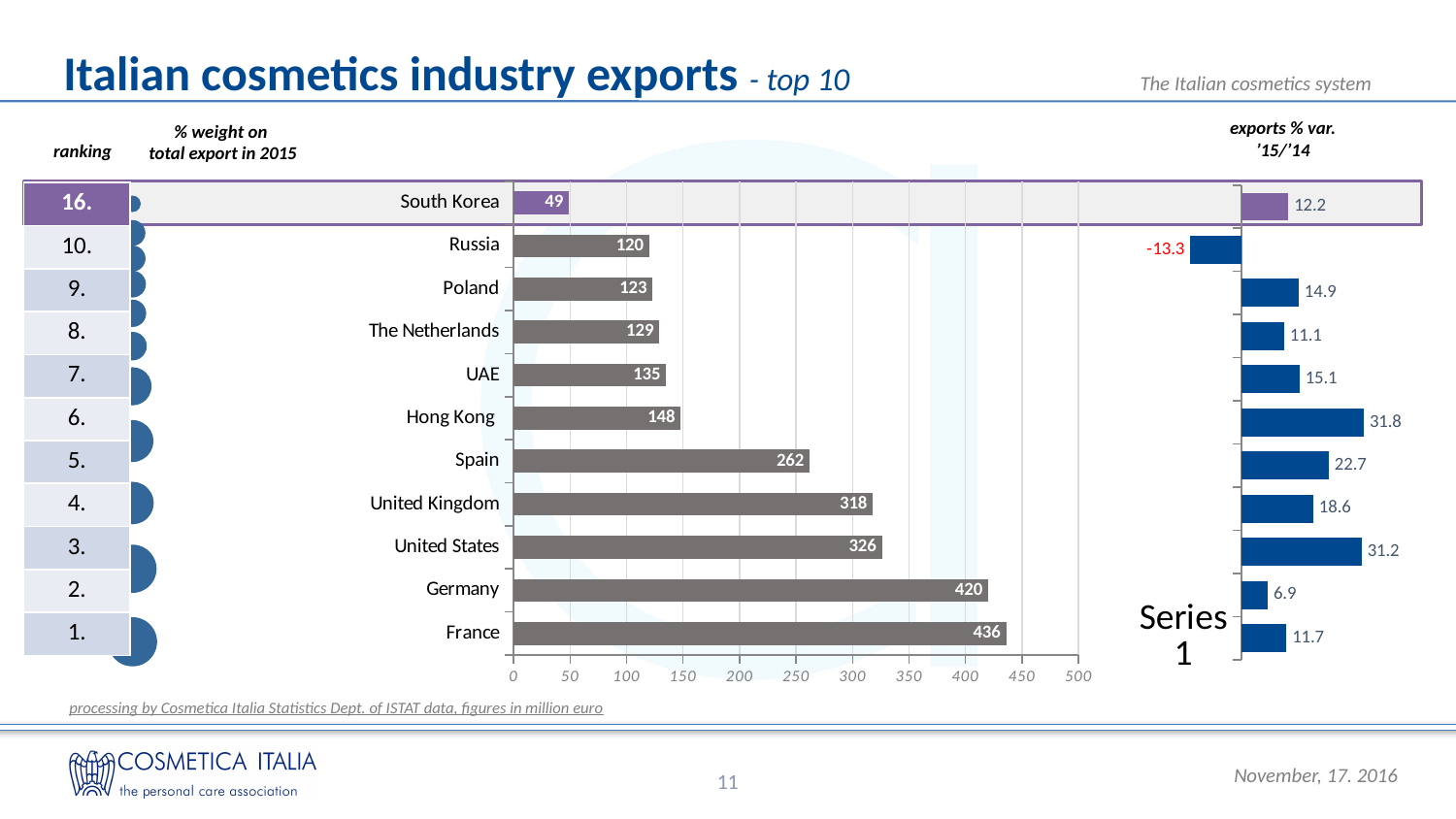
In the left chart of export values, which country has the lowest value? South Korea What kind of chart is the left chart of export values? bar chart How many countries are plotted in the left chart of export values? 11 In the left chart of export values, what is the value for France? 436 In the left chart of export values, what is the difference between France and Germany? 16 In the right chart of exports % var. '15/'14, what is the value for Hong Kong? 31.8 In the left chart of export values, what is the value for Hong Kong? 148 In the right chart of exports % var. '15/'14, which is larger, Spain or Germany? Spain In the right chart of exports % var. '15/'14, which country has the lowest value? Russia In the right chart of exports % var. '15/'14, what is the value for Russia? -13.3 In the left chart of export values, which country has the highest value? France In the left chart of export values, which is larger, United States or United Kingdom? United States